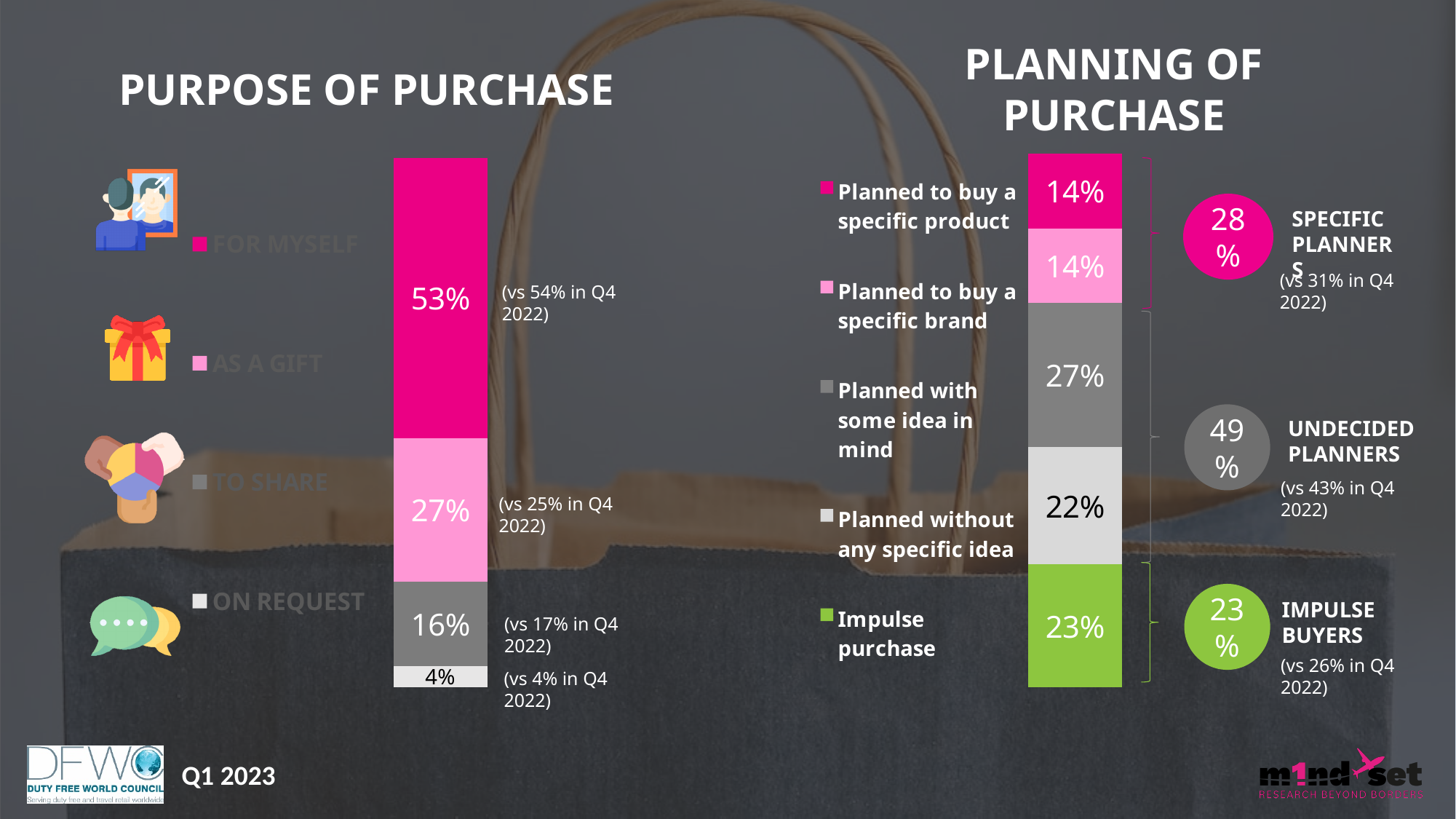
In the Planning of Purchase chart, which is larger: impulse purchase or planned without any specific idea? Impulse purchase In the Purpose of Purchase chart, how many legend entries are listed? 4 In the Planning of Purchase chart, which category has the highest share? Planned with some idea in mind In the Purpose of Purchase chart, what is the difference between the 'for myself' and 'to share' shares? 37 percentage points In the Purpose of Purchase chart, which purpose has the lowest share? On request In the Purpose of Purchase chart, what percentage of purchases are for myself? 53% In the Planning of Purchase chart, what percentage planned to buy a specific brand? 14% In the Planning of Purchase chart, what is the combined share of planned to buy a specific product and planned to buy a specific brand? 28% What type of chart is used for Planning of Purchase? Stacked bar chart In the Purpose of Purchase chart, what percentage of purchases are as a gift? 27% In the Planning of Purchase chart, what percentage planned with some idea in mind? 27% In the Purpose of Purchase chart, what percentage of purchases are on request? 4%